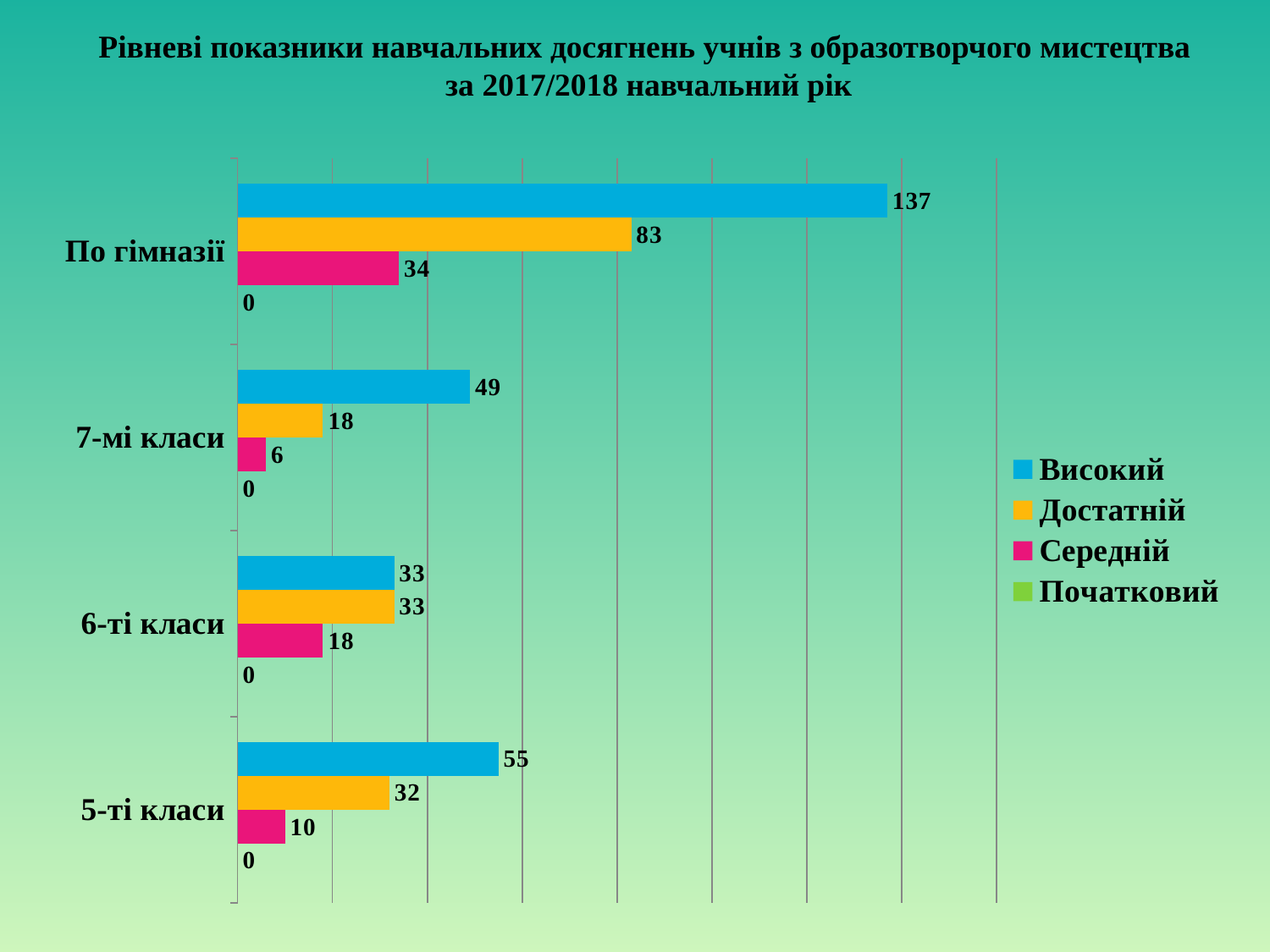
What is the value for Початковий for 6-ті класи? 0 Among the class categories (5-ті, 6-ті, 7-мі класи), which has the lowest value for Середній? 7-мі класи How many series does the legend list? 4 What is the value for Середній for 7-мі класи? 6 Which is larger for 7-мі класи: Високий or Достатній? Високий How many categories are shown on the vertical axis? 4 Which colour represents the Достатній series in the legend? Orange Which category has the highest value for Високий? По гімназії What is the value for Достатній for 5-ті класи? 32 What kind of chart is shown on the slide? Bar chart What is the value for Високий for По гімназії? 137 What is the difference between the Високий and Достатній values for По гімназії? 54